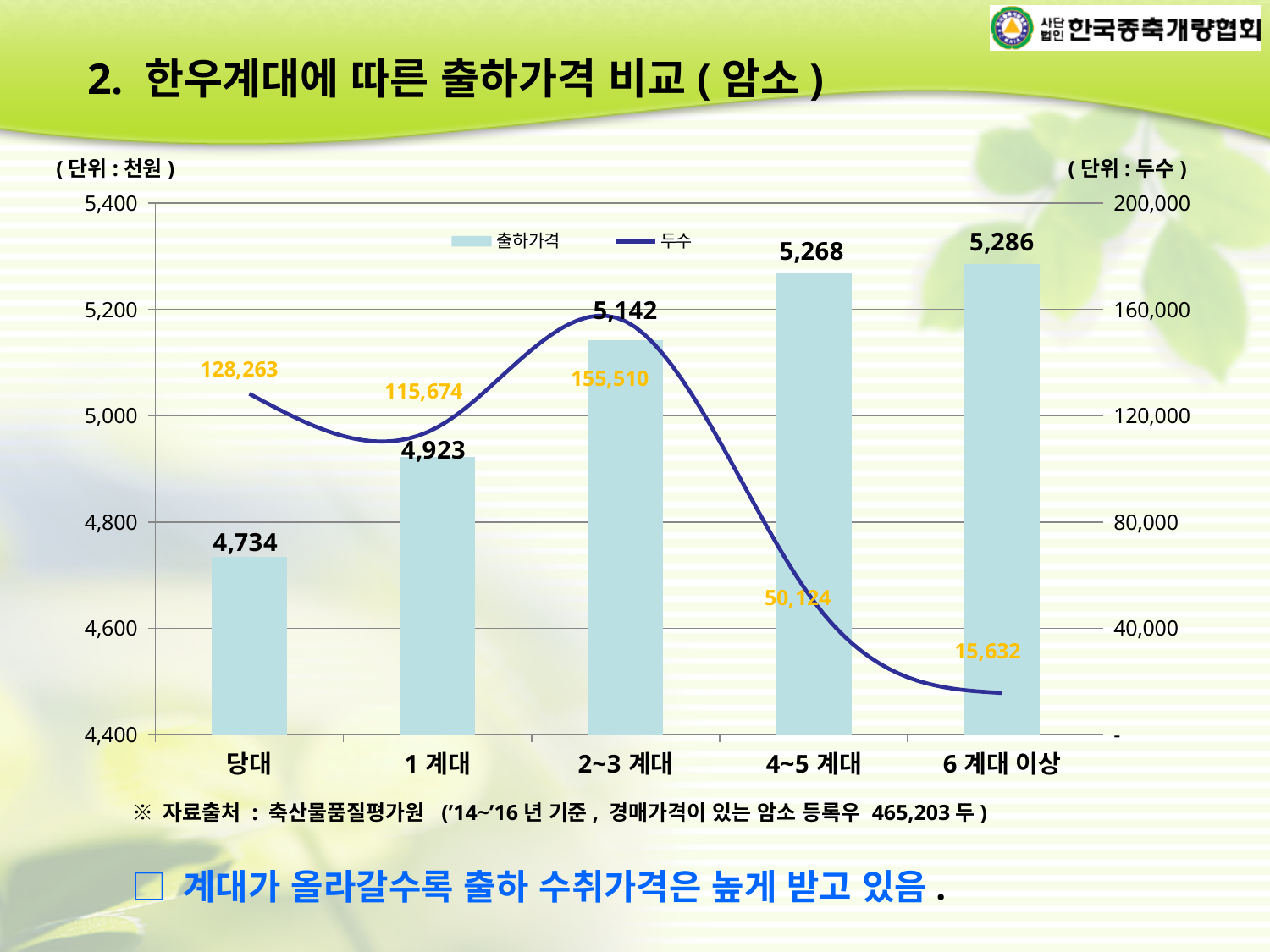
Which category has the highest 출하가격? 6 계대 이상 What is the 두수 value for 6 계대 이상? 15,632 How many categories are shown on the x axis? 5 What is the 두수 value for 2~3 계대? 155,510 What is the difference in 출하가격 between 6 계대 이상 and 당대? 552 What is the 출하가격 value for 당대? 4,734 Which series is drawn as a line rather than bars? 두수 Which category has the lowest 두수? 6 계대 이상 Does the 출하가격 rise or fall as you move from 당대 to 6 계대 이상? rise Which has a larger 두수 value, 당대 or 1 계대? 당대 What is the 출하가격 value for 4~5 계대? 5,268 How many series does the legend list? 2